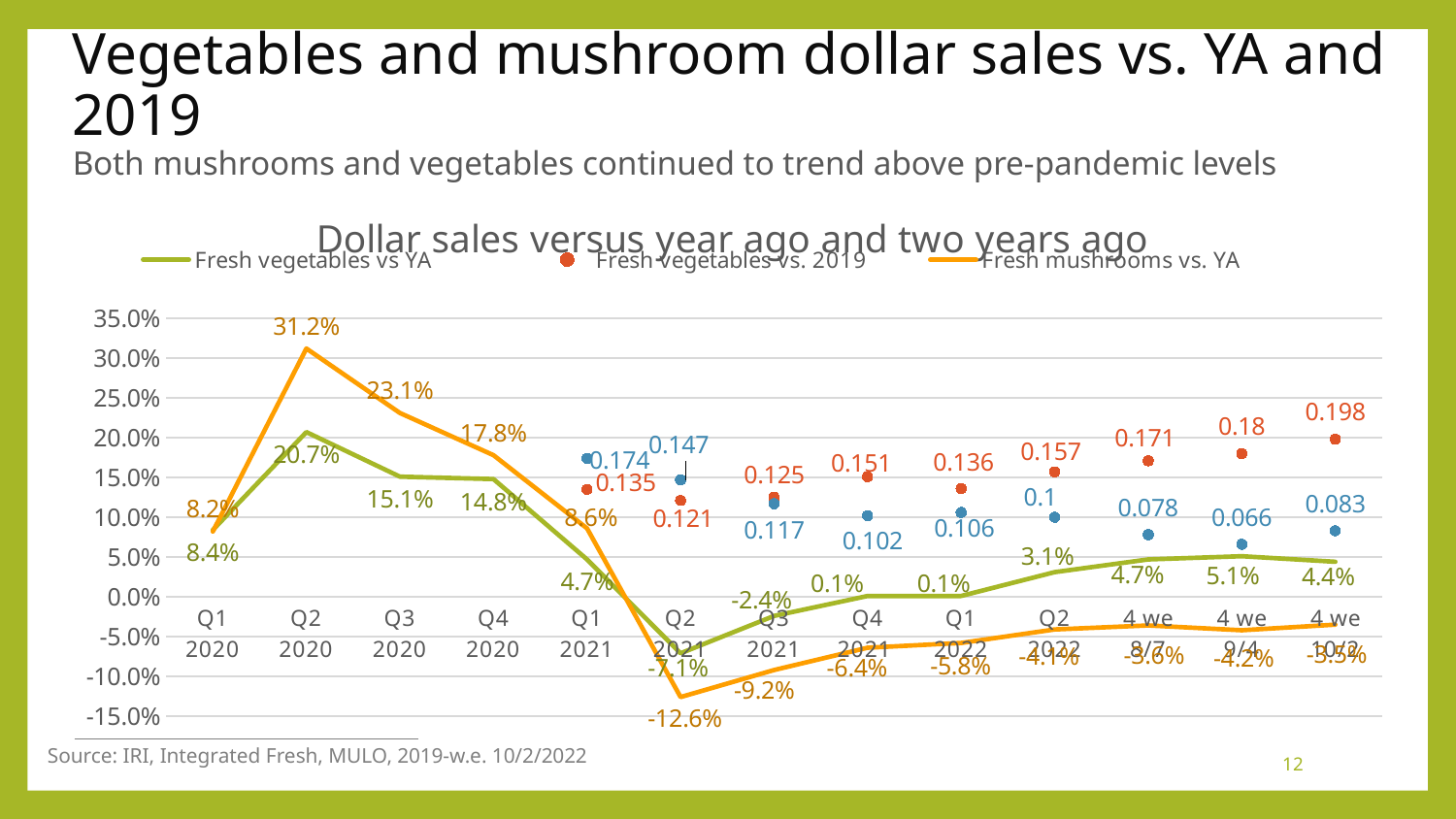
What is the Fresh vegetables vs YA value for Q2 2021? -7.1% What kind of chart is shown on the slide? line chart In which period is Fresh mushrooms vs. YA at its lowest? Q2 2021 In Q2 2020, which is larger: Fresh mushrooms vs. YA or Fresh vegetables vs YA? Fresh mushrooms vs. YA What is the title of the chart? Dollar sales versus year ago and two years ago How many series does the chart legend list? 3 From Q2 2022 to 4 we 10/2, do the Fresh vegetables vs. 2019 values rise or fall? rise What is the difference between the Fresh mushrooms vs. YA values for Q2 2020 and Q3 2020? 8.1 percentage points What is the Fresh mushrooms vs. YA value for Q2 2020? 31.2% What is the Fresh vegetables vs. 2019 value for the 4 we 10/2 period? 0.198 How many time periods are shown along the x axis? 13 In which period is Fresh vegetables vs YA at its highest? Q2 2020